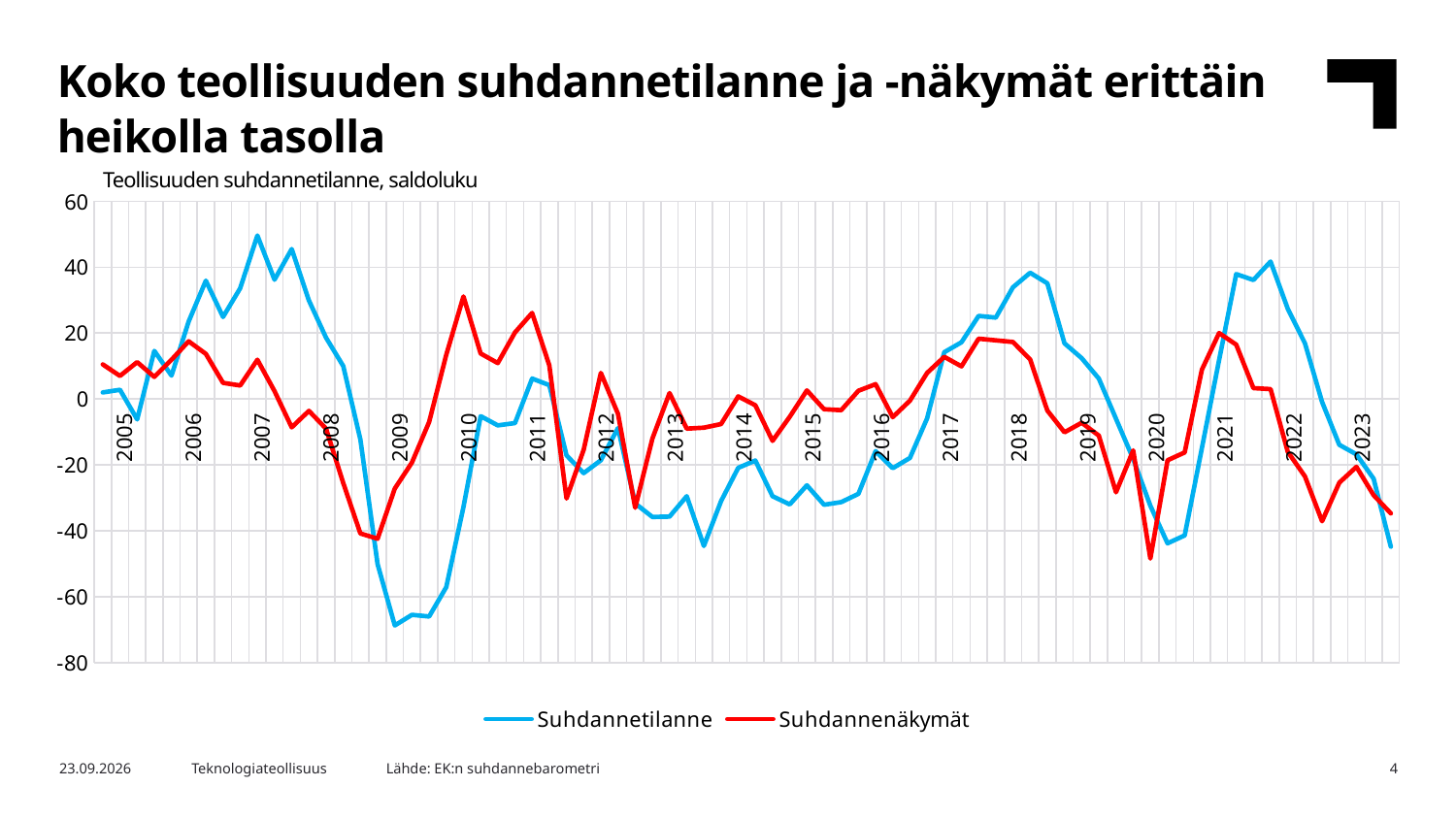
How many series does the legend list? 2 Does the Suhdannetilanne line rise or fall from its 2021 peak to the end of 2023? fall Is the lowest value of the Suhdannetilanne line, reached around 2009, greater or less than -60? less What are the two series named in the legend? Suhdannetilanne and Suhdannenäkymät Is the lowest value of the Suhdannenäkymät line, reached around 2020, greater or less than -40? less How many year labels are shown on the x axis? 19 Is the peak of the Suhdannenäkymät line around 2010 greater or less than 20? greater Around 2009, which series reaches the lower value, Suhdannetilanne or Suhdannenäkymät? Suhdannetilanne At the right end of the chart (2023), which series has the higher value, Suhdannetilanne or Suhdannenäkymät? Suhdannenäkymät What type of chart is shown on the slide? line chart What is the title printed above the chart? Teollisuuden suhdannetilanne, saldoluku